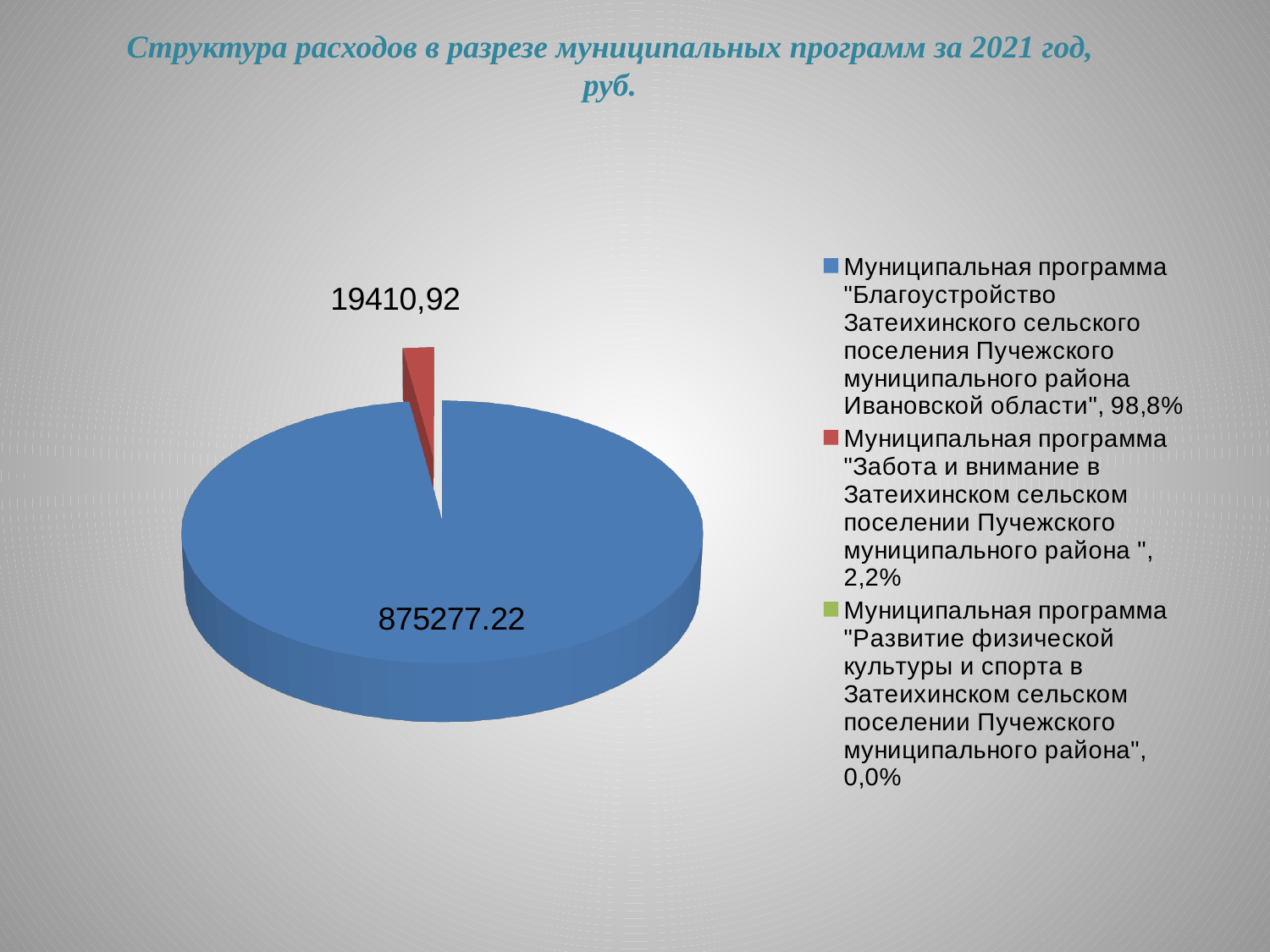
How many municipal programmes are listed in the legend? 3 What kind of chart is shown on the slide? Pie chart What share of expenditure does the programme "Благоустройство Затеихинского сельского поселения" account for, according to the legend? 98,8% Which is larger: the value for the "Благоустройство" programme or the value for the "Забота и внимание" programme? "Благоустройство" programme What share of expenditure does the programme "Забота и внимание в Затеихинском сельском поселении" account for, according to the legend? 2,2% What value is shown for the municipal programme "Благоустройство Затеихинского сельского поселения Пучежского муниципального района Ивановской области"? 875277.22 Which municipal programme has the largest slice of the pie? "Благоустройство Затеихинского сельского поселения Пучежского муниципального района Ивановской области" What share is shown in the legend for the programme "Развитие физической культуры и спорта в Затеихинском сельском поселении"? 0,0% What colour is the slice for the programme "Забота и внимание в Затеихинском сельском поселении"? Red What value is shown for the municipal programme "Забота и внимание в Затеихинском сельском поселении Пучежского муниципального района"? 19410,92 What is the title of the chart? Структура расходов в разрезе муниципальных программ за 2021 год, руб. Which municipal programme has the smallest share of expenditure according to the legend? "Развитие физической культуры и спорта в Затеихинском сельском поселении Пучежского муниципального района"